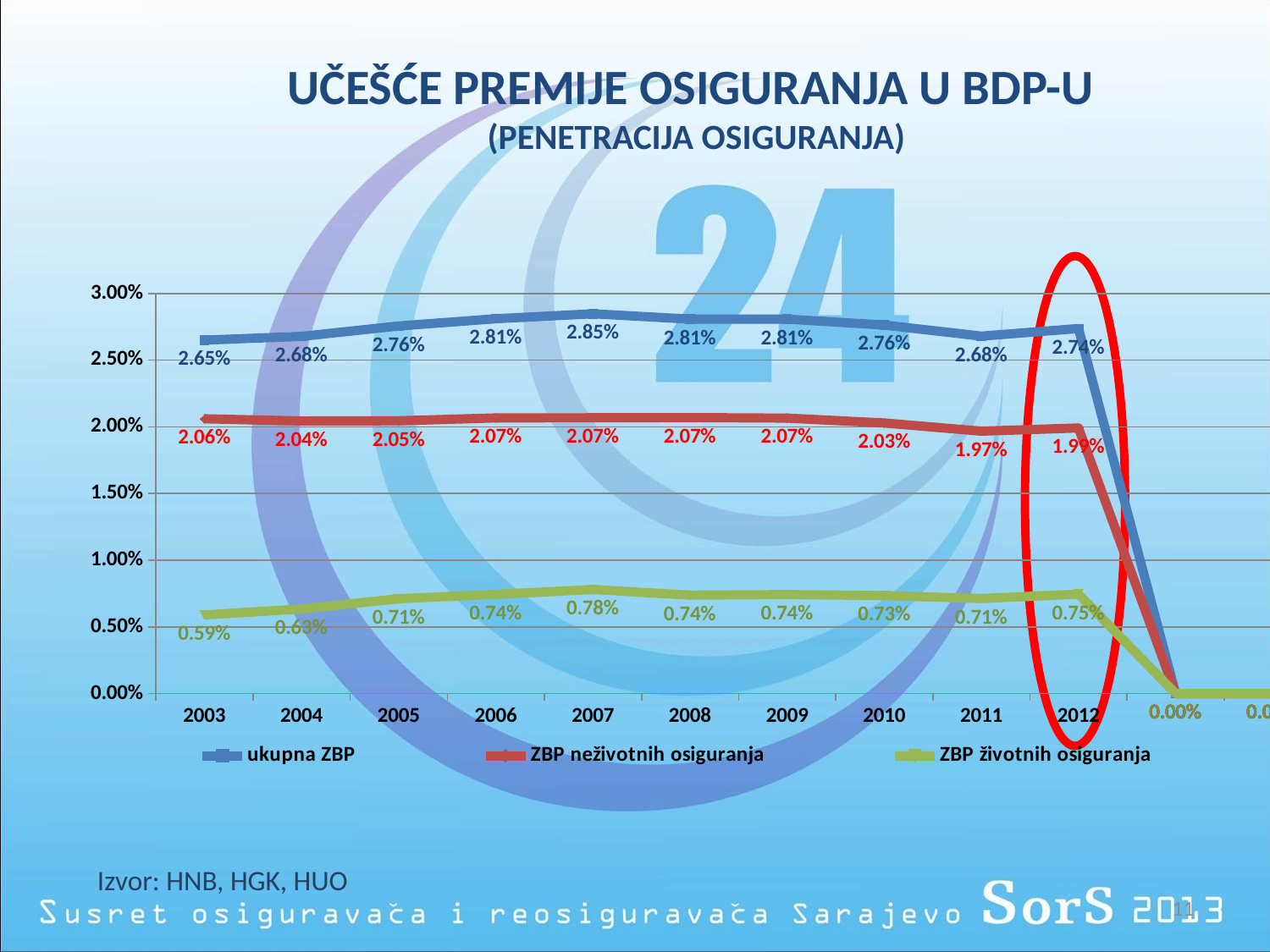
What kind of chart is shown on the slide? line chart What is the difference between ukupna ZBP and ZBP neživotnih osiguranja in 2012? 0.75% How many series does the legend list? 3 What is the value of ZBP životnih osiguranja in 2003? 0.59% In which year is ZBP životnih osiguranja at its lowest? 2003 What is the difference between ukupna ZBP in 2007 and in 2003? 0.20% In which year does ukupna ZBP reach its highest value? 2007 What is the value of ukupna ZBP in 2007? 2.85% Which is larger: ZBP neživotnih osiguranja in 2003 or in 2012? 2003 In which year is ZBP neživotnih osiguranja at its lowest? 2011 Does ZBP životnih osiguranja rise or fall from 2003 to 2007? rise What is the value of ZBP neživotnih osiguranja in 2011? 1.97%